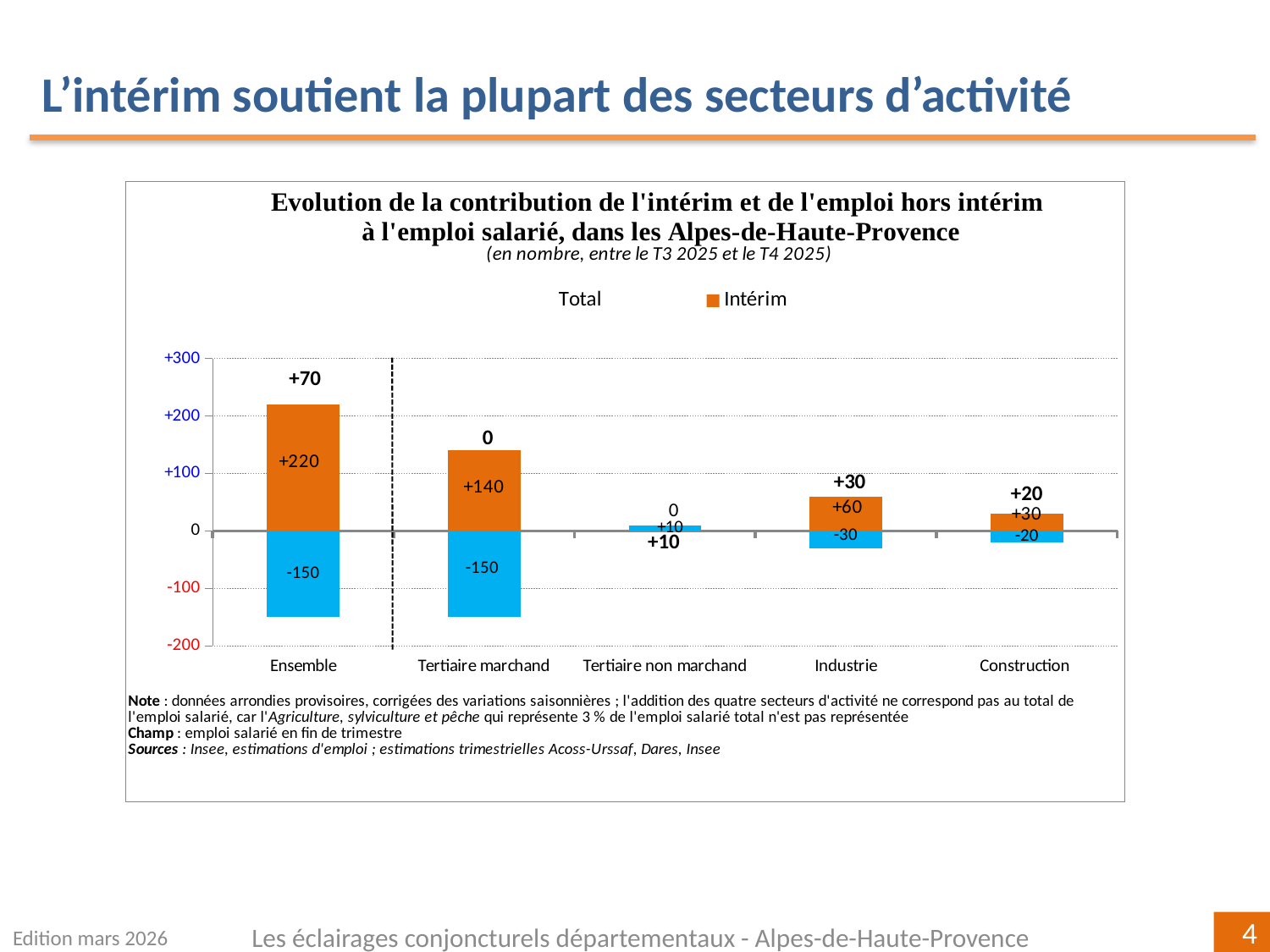
Which category has the highest Intérim value? Ensemble What kind of chart is this? Bar chart How many categories are shown on the x axis? 5 What is the value of the blue bar for Tertiaire marchand? -150 What is the Intérim value for Ensemble? +220 What is the Intérim value for Industrie? +60 What is the total value shown for Tertiaire marchand? 0 Which category has the lowest Intérim value? Tertiaire non marchand What is the total value shown above the bars for Construction? +20 What colour represents the Intérim series? Orange Which has the larger Intérim value, Industrie or Construction? Industrie What is the difference between the Intérim values for Ensemble and Tertiaire marchand? 80